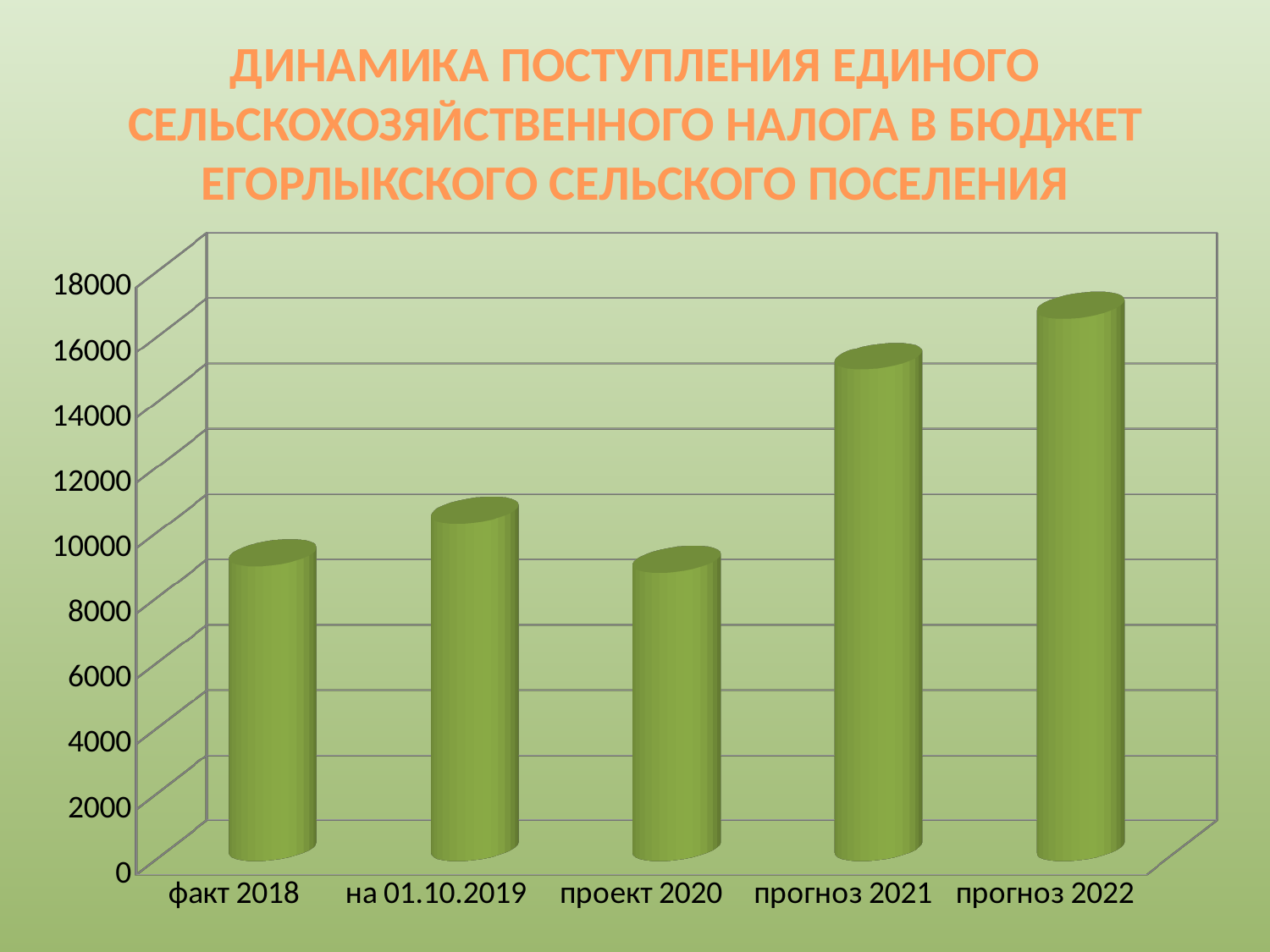
Is the value for факт 2018 greater or less than 8000? greater What is the highest tick value shown on the vertical axis of the chart? 18000 Is the value for прогноз 2022 greater or less than 16000? greater How many categories are shown on the x axis of the chart? 5 Is the value for на 01.10.2019 greater or less than 12000? less What kind of chart is shown on the slide? bar chart Does the value rise or fall from прогноз 2021 to прогноз 2022? rise Which category has the highest value in the chart? прогноз 2022 Which is larger, the value for прогноз 2021 or the value for на 01.10.2019? прогноз 2021 Which is larger, the value for факт 2018 or the value for на 01.10.2019? на 01.10.2019